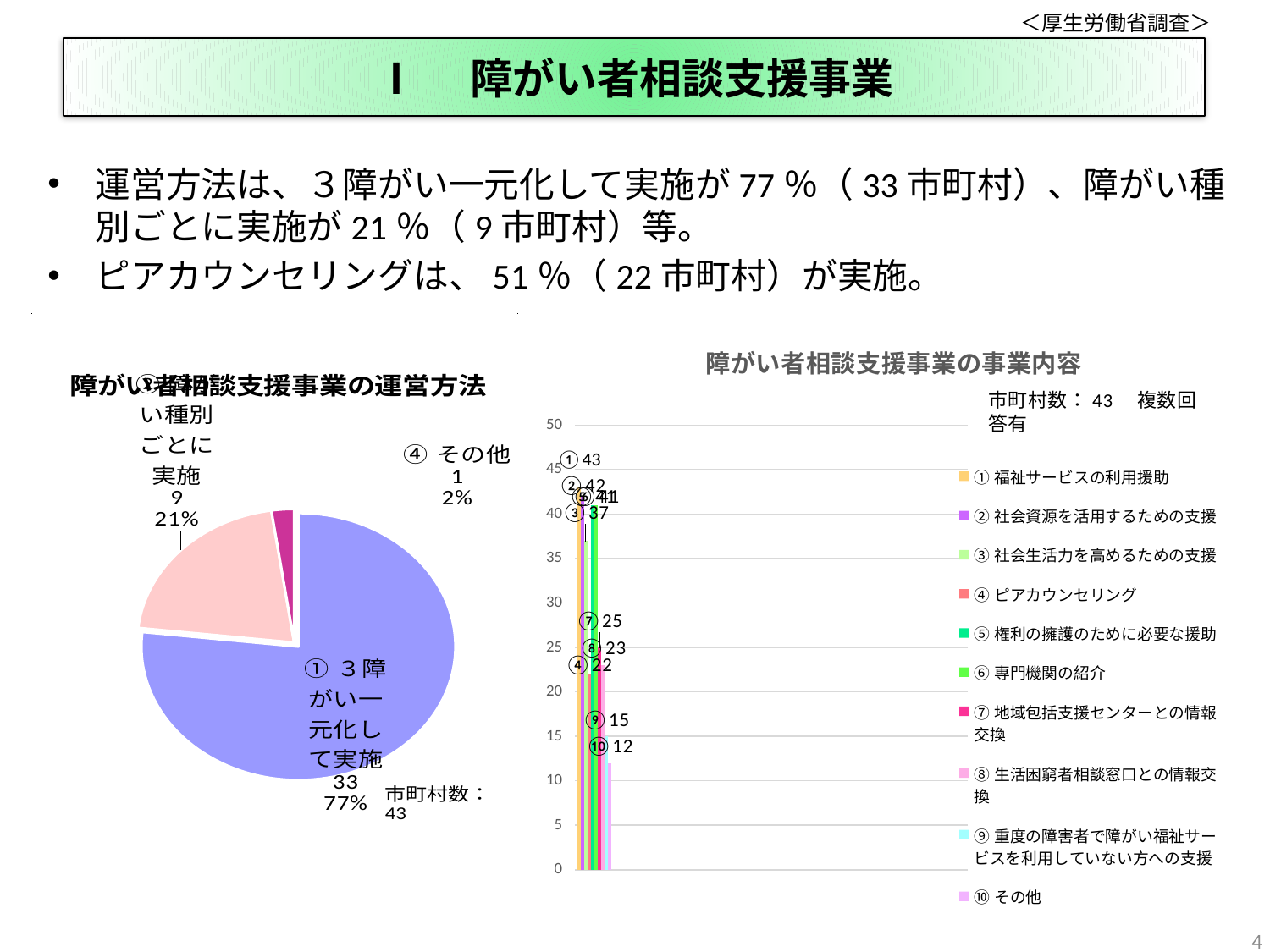
What kind of chart is the right chart, 障がい者相談支援事業の事業内容? Bar chart In the bar chart 障がい者相談支援事業の事業内容, how many series does the legend list? 10 In the pie chart 障がい者相談支援事業の運営方法, what is the difference in municipalities between ① ３障がい一元化して実施 (33) and ② 障がい種別ごとに実施 (9)? 24 In the bar chart 障がい者相談支援事業の事業内容, what is the value for ④ ピアカウンセリング? 22 In the bar chart 障がい者相談支援事業の事業内容, what is the difference between ② 社会資源を活用するための支援 (42) and ③ 社会生活力を高めるための支援 (37)? 5 In the bar chart 障がい者相談支援事業の事業内容, what is the value for ① 福祉サービスの利用援助? 43 In the pie chart 障がい者相談支援事業の運営方法, how many municipalities are in the ④ その他 slice? 1 What kind of chart is the left chart, 障がい者相談支援事業の運営方法? Pie chart In the bar chart 障がい者相談支援事業の事業内容, which item has the lowest value? ⑩ その他 In the bar chart 障がい者相談支援事業の事業内容, which is larger: ⑦ 地域包括支援センターとの情報交換 or ⑨ 重度の障害者で障がい福祉サービスを利用していない方への支援? ⑦ 地域包括支援センターとの情報交換 In the pie chart 障がい者相談支援事業の運営方法, which slice is the largest? ① ３障がい一元化して実施 In the pie chart 障がい者相談支援事業の運営方法, what percentage share does ① ３障がい一元化して実施 have? 77%